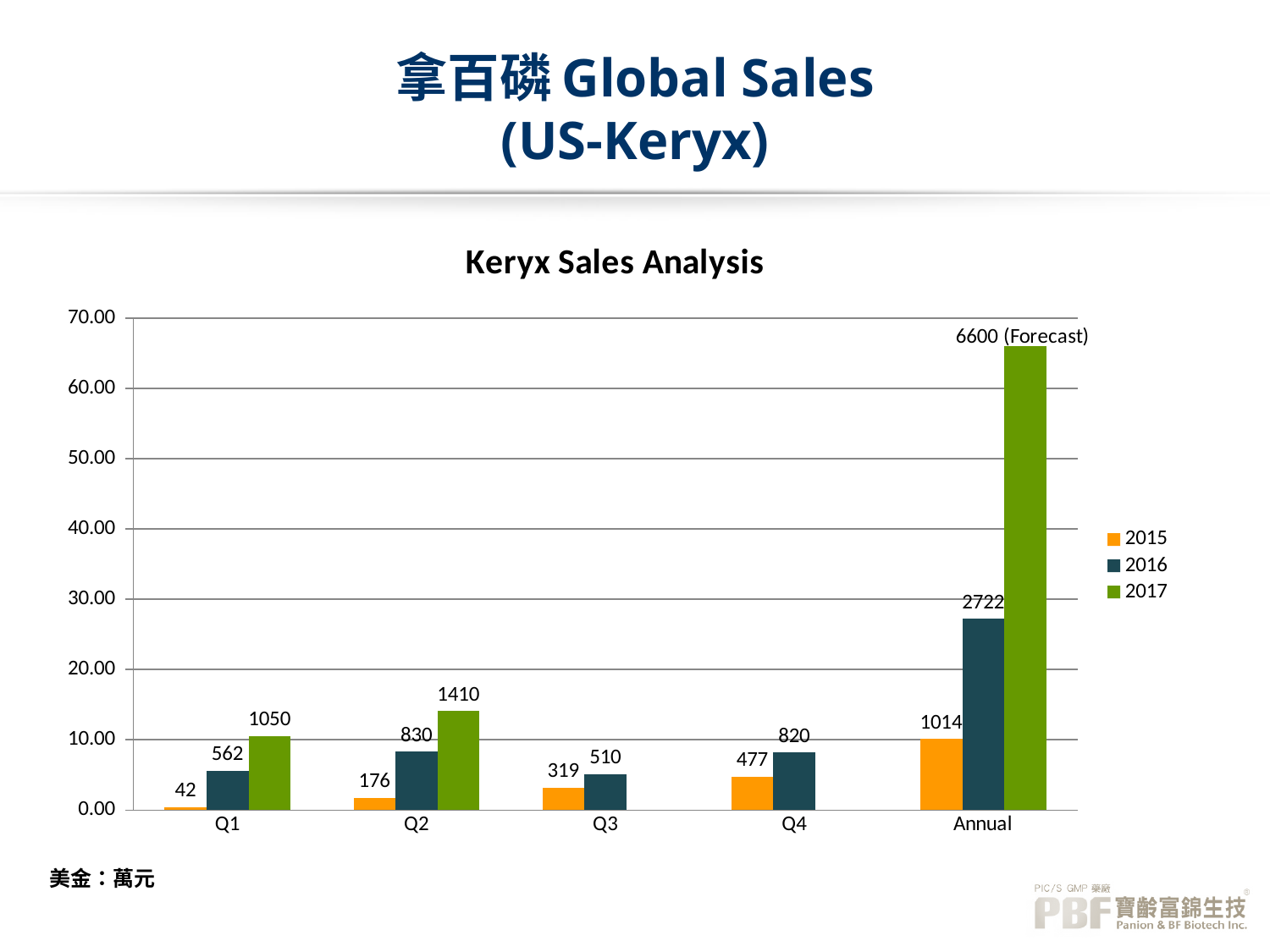
What is the difference between the 2016 and 2015 values for Q2? 654 What is the 2016 value for Q2? 830 What is the difference between the 2016 and 2015 Annual values? 1708 Among Q1, Q2, Q3 and Q4, which quarter has the highest 2015 value? Q4 Do the 2015 values rise or fall from Q1 to Q4? Rise Which is larger, the 2016 value for Q3 or the 2016 value for Q4? Q4 How many series does the legend list? 3 How many categories are shown on the x axis? 5 What kind of chart is shown? Bar chart What is the data label on the 2017 bar for Annual? 6600 (Forecast) What is the 2015 value for Q1? 42 Among Q1, Q2, Q3 and Q4, which quarter has the lowest 2016 value? Q3